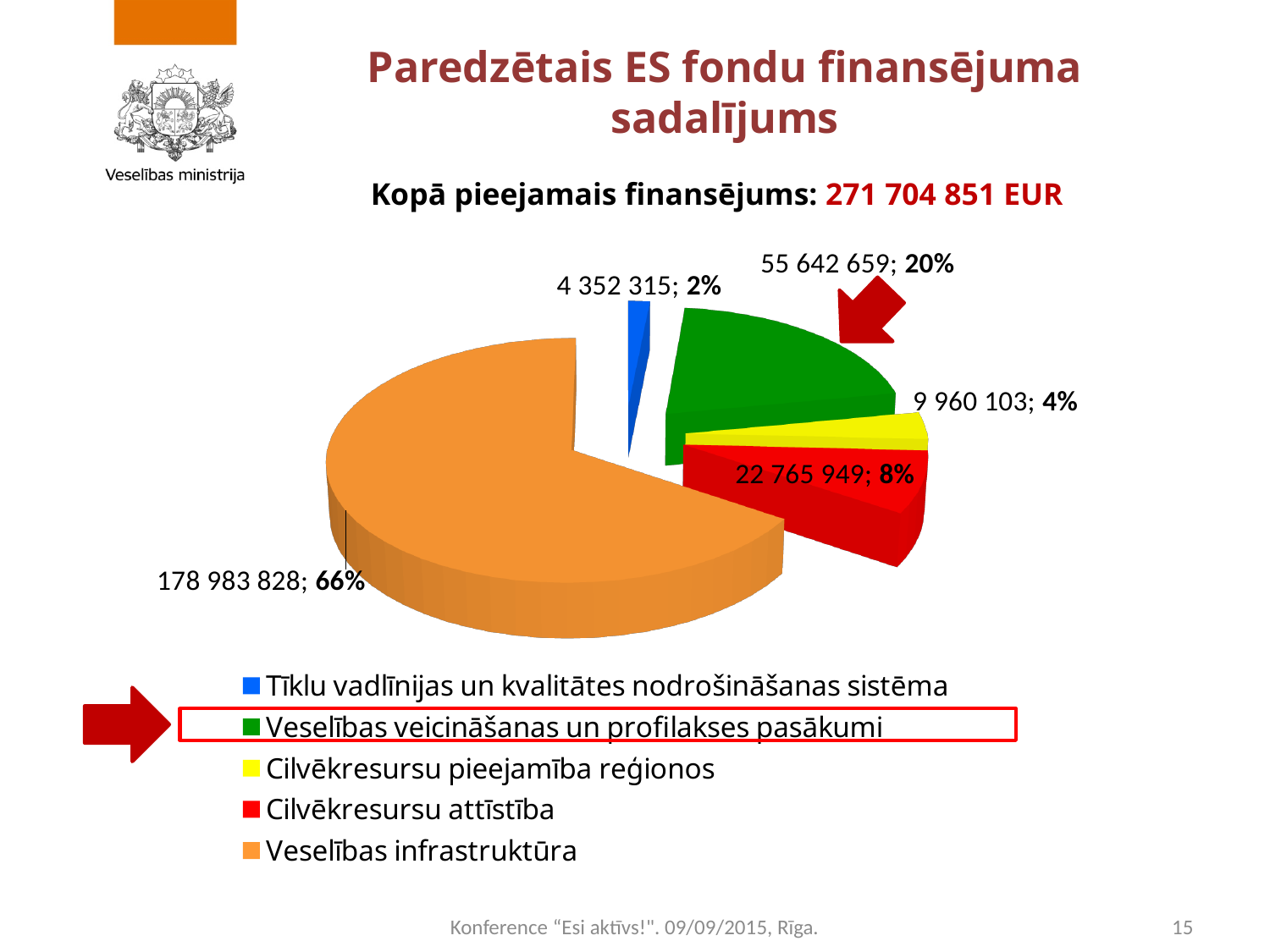
What colour is the slice for Veselības infrastruktūra? orange What value is shown for Cilvēkresursu pieejamība reģionos? 9 960 103 What value is shown for Cilvēkresursu attīstība? 22 765 949 How many slices does the pie chart have? 5 What kind of chart is shown on the slide? pie chart Which is larger, the value for Cilvēkresursu attīstība or the value for Cilvēkresursu pieejamība reģionos? Cilvēkresursu attīstība Which category has the largest slice of the pie? Veselības infrastruktūra What value is shown for Veselības infrastruktūra? 178 983 828 Which category has the smallest slice of the pie? Tīklu vadlīnijas un kvalitātes nodrošināšanas sistēma What share of the pie does Veselības veicināšanas un profilakses pasākumi represent? 20% What is the difference in percentage share between Veselības veicināšanas un profilakses pasākumi and Cilvēkresursu attīstība? 12% What share of the pie does Tīklu vadlīnijas un kvalitātes nodrošināšanas sistēma represent? 2%